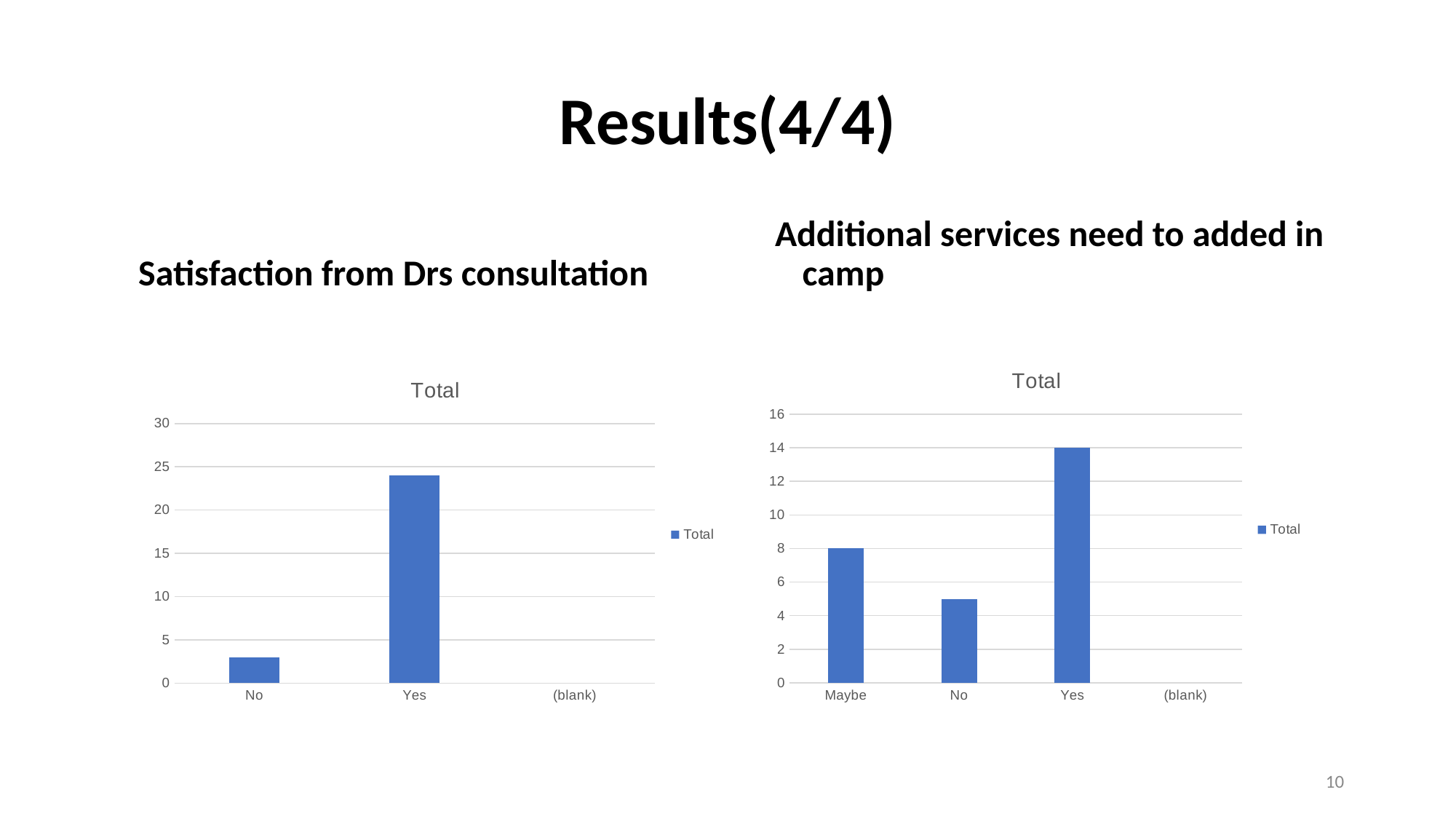
How many series does the legend of the 'Additional services need to added in camp' chart list? 1 In the 'Satisfaction from Drs consultation' chart, is the value for Yes greater or less than 20? greater In the 'Additional services need to added in camp' chart, what is the value for Maybe? 8 In the 'Additional services need to added in camp' chart, is the value for No greater or less than 6? less What kind of chart is the 'Satisfaction from Drs consultation' chart? bar chart In the 'Additional services need to added in camp' chart, what is the difference between the values for Yes and Maybe? 6 In the 'Satisfaction from Drs consultation' chart, is the value for No greater or less than 5? less In the 'Additional services need to added in camp' chart, which category has the lowest non-empty bar among Maybe, No and Yes? No In the 'Satisfaction from Drs consultation' chart, which category has the highest bar? Yes In the 'Additional services need to added in camp' chart, what is the value for Yes? 14 In the 'Additional services need to added in camp' chart, how many categories are shown on the x axis? 4 In the 'Satisfaction from Drs consultation' chart, how many categories are shown on the x axis? 3